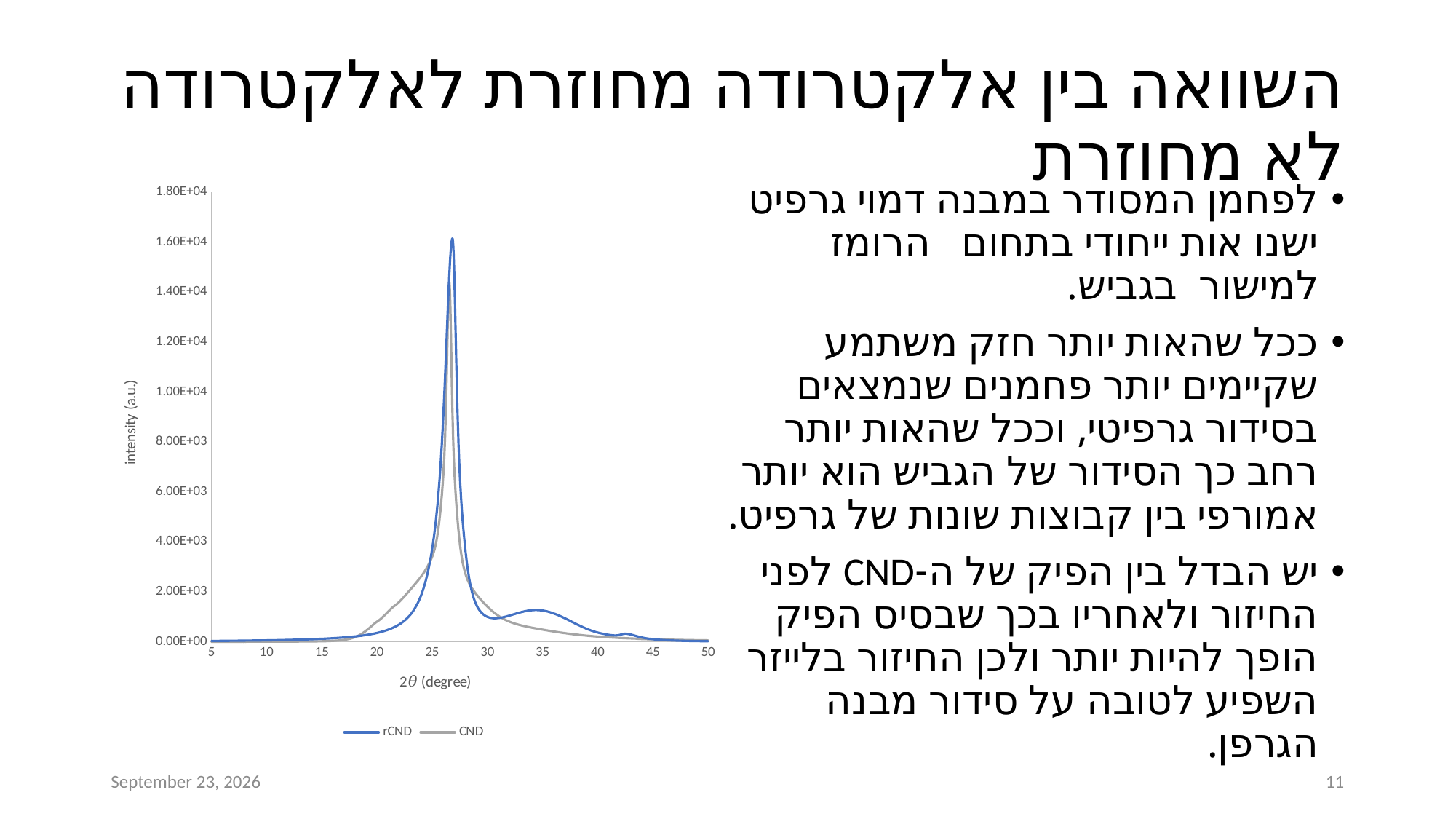
Does the intensity of the rCND series rise or fall between 2θ = 27 and 2θ = 30 degrees? fall Is the peak intensity of the CND series greater or less than 1.60E+04? less Is the peak intensity of the rCND series greater or less than 1.40E+04? greater What are the two series named in the chart legend? rCND and CND What is the highest value shown on the chart's y axis? 1.80E+04 Is the intensity of the CND series at 2θ = 10 degrees greater or less than 2.00E+03? less What kind of chart is shown on the slide? line chart Which series reaches the higher peak intensity, rCND or CND? rCND What is the label of the chart's x axis? 2θ (degree) What is the largest 2θ value shown on the chart's x axis? 50 How many series does the chart legend list? 2